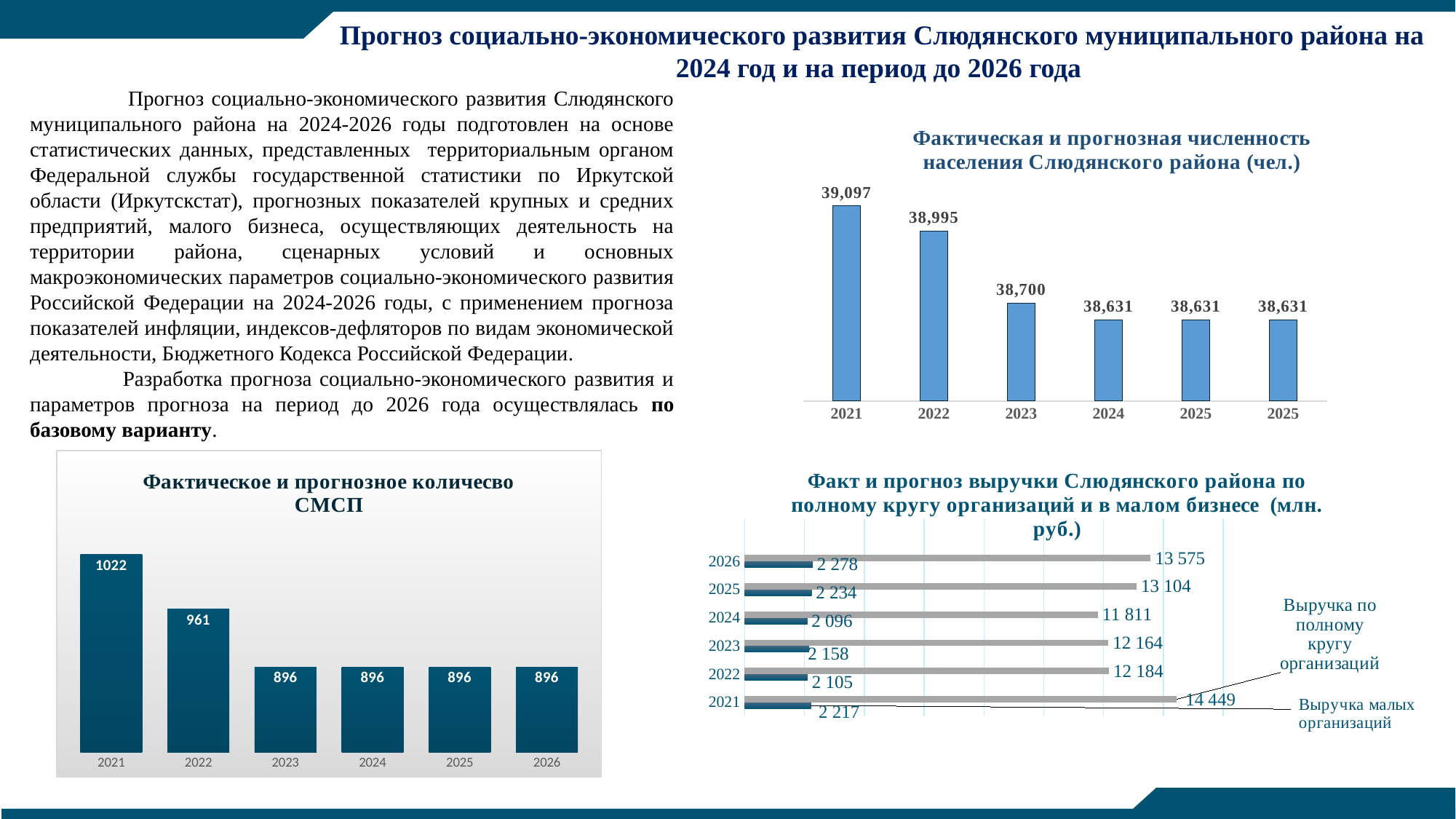
In the revenue chart (Факт и прогноз выручки), what is the value of Выручка малых организаций for 2024? 2 096 In the СМСП chart (Фактическое и прогнозное количесво СМСП), what kind of chart is it? bar chart In the population chart (Фактическая и прогнозная численность населения), do the values rise or fall from 2021 to 2024? fall In the СМСП chart (Фактическое и прогнозное количесво СМСП), what is the difference between the 2021 and 2023 values? 126 In the population chart (Фактическая и прогнозная численность населения), what is the difference between the 2021 and 2022 values? 102 In the revenue chart (Факт и прогноз выручки), what is the value of Выручка по полному кругу организаций for 2026? 13 575 In the population chart (Фактическая и прогнозная численность населения), what is the value for 2021? 39,097 In the population chart (Фактическая и прогнозная численность населения), which year has the highest value? 2021 In the population chart (Фактическая и прогнозная численность населения), what is the value for 2023? 38,700 In the СМСП chart (Фактическое и прогнозное количесво СМСП), how many bars are plotted? 6 In the СМСП chart (Фактическое и прогнозное количесво СМСП), what is the value for 2022? 961 In the revenue chart (Факт и прогноз выручки), which year has the highest value of Выручка по полному кругу организаций? 2021